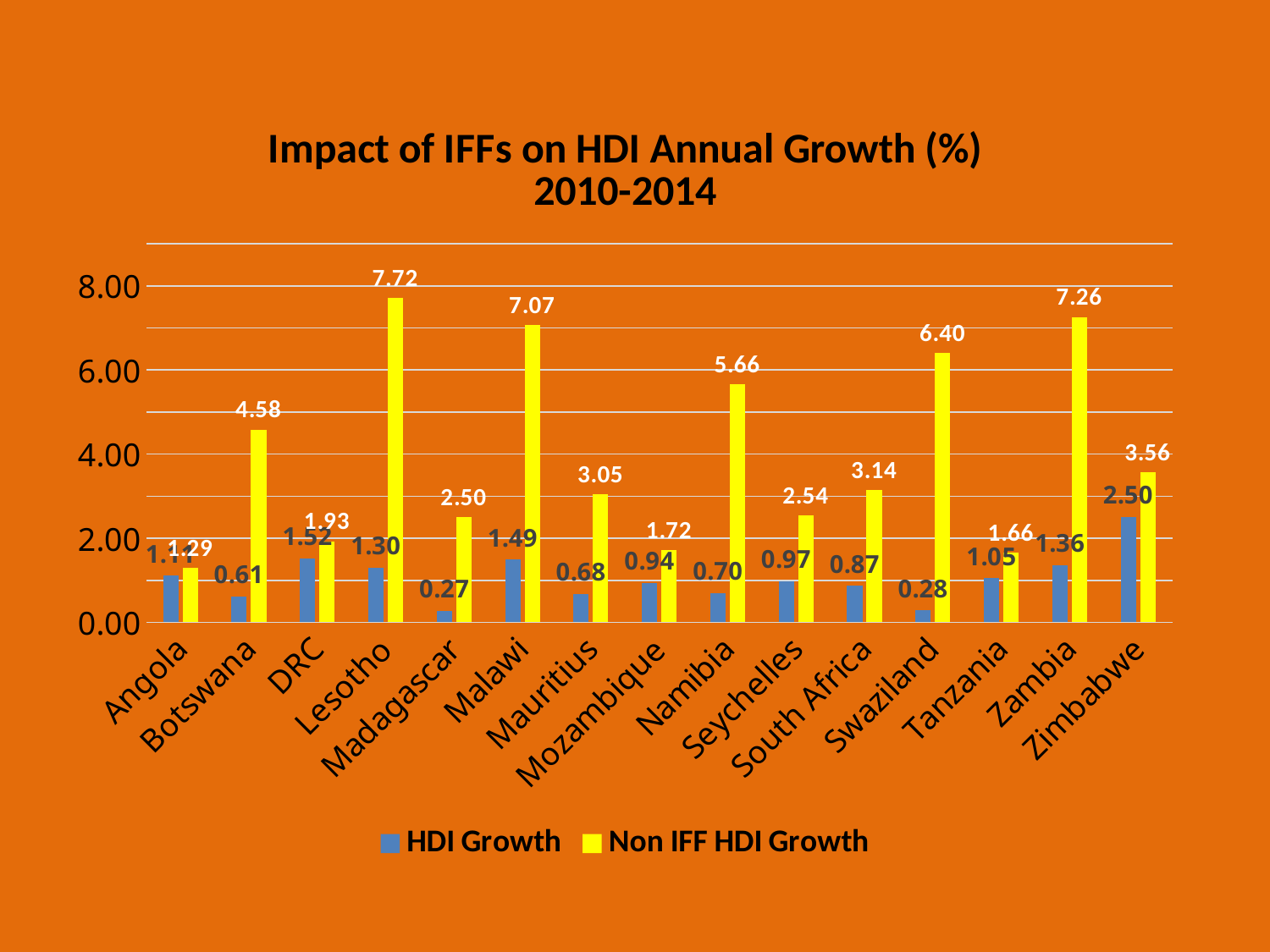
What is the difference between the Non IFF HDI Growth and HDI Growth values for Lesotho? 6.42 What is the HDI Growth value for Madagascar? 0.27 What is the HDI Growth value for Zimbabwe? 2.50 Which country has the highest Non IFF HDI Growth value? Lesotho What is the Non IFF HDI Growth value for Swaziland? 6.40 How many series does the legend list? 2 Is the Non IFF HDI Growth value for Namibia greater or less than 4.00? greater Which is larger for Malawi: HDI Growth or Non IFF HDI Growth? Non IFF HDI Growth What is the Non IFF HDI Growth value for Lesotho? 7.72 How many countries are shown on the x axis? 15 Which country has the highest HDI Growth value? Zimbabwe Which country has the lowest Non IFF HDI Growth value? Angola